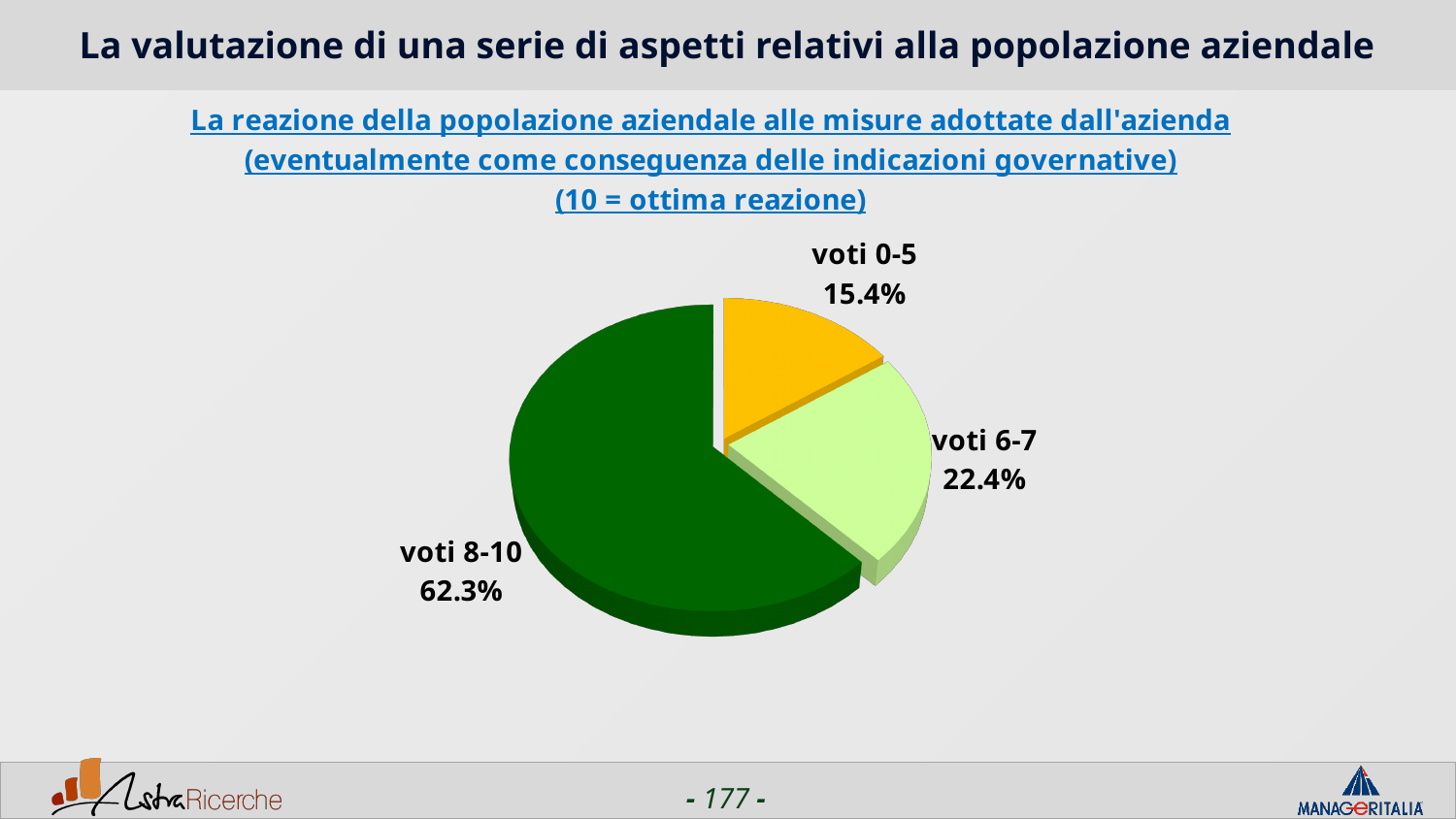
Which category has the largest slice of the pie? voti 8-10 What kind of chart is shown on the slide? pie chart What colour is the 'voti 0-5' slice? orange Which category has the smallest slice of the pie? voti 0-5 What is the difference in percentage points between 'voti 8-10' and 'voti 6-7'? 39.9 How many slices does the pie chart have? 3 Which is larger, the slice for 'voti 6-7' or the slice for 'voti 0-5'? voti 6-7 According to the chart subtitle, what score corresponds to 'ottima reazione'? 10 What share of the pie does the 'voti 8-10' slice represent? 62.3% What is the difference in percentage points between 'voti 6-7' and 'voti 0-5'? 7.0 What is the value shown for 'voti 0-5'? 15.4% What is the value shown for 'voti 6-7'? 22.4%